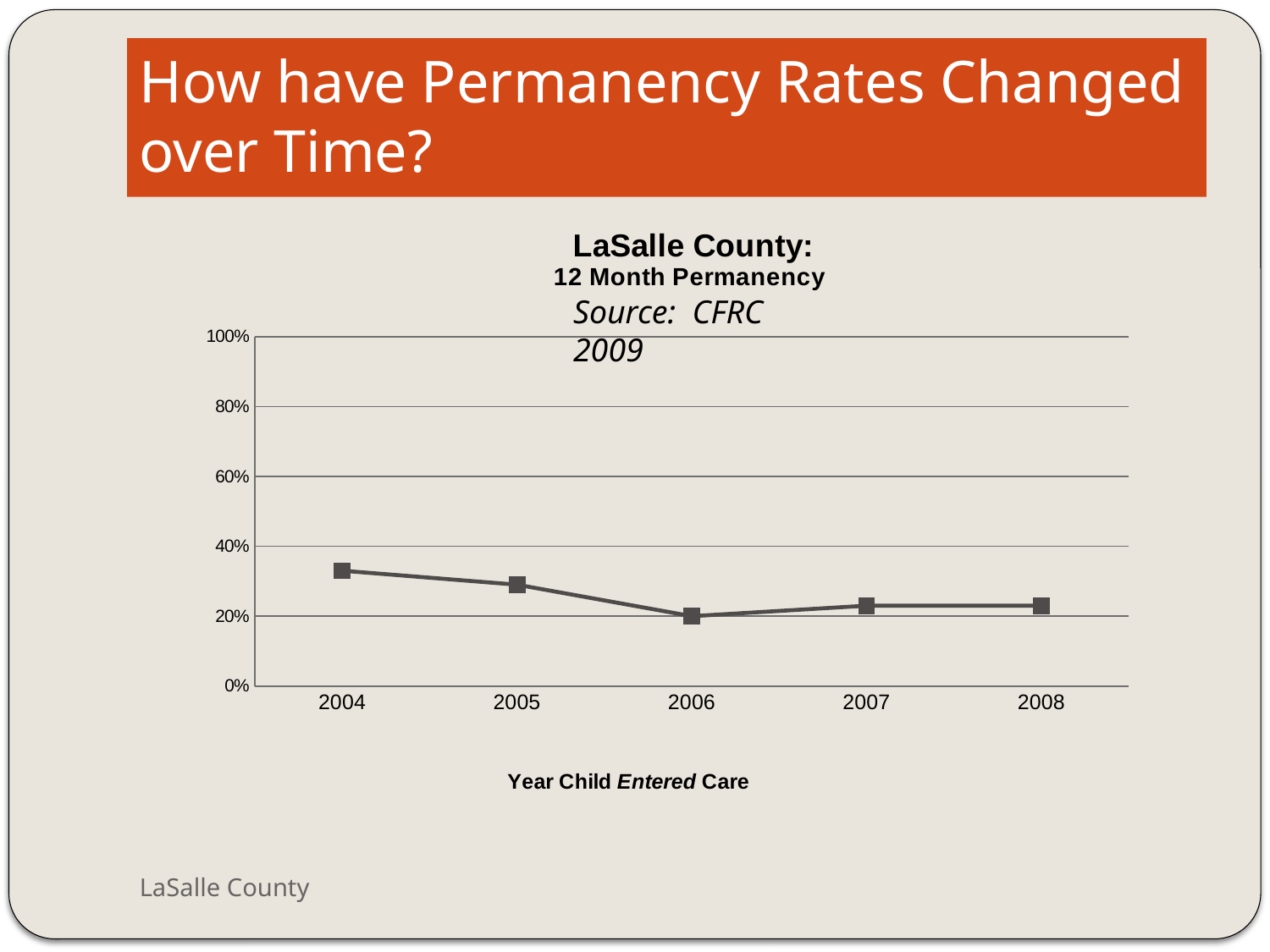
What kind of chart is shown on the slide? Line chart Is the value for 2004 greater or less than 20%? greater Which year has the higher permanency rate, 2004 or 2005? 2004 How many years are plotted on the x axis of the chart? 5 Is the value for 2008 greater or less than 40%? less Which year has the lowest 12 month permanency rate? 2006 Which year has the highest 12 month permanency rate? 2004 Is the value for 2004 greater or less than 40%? less What is the title of the x axis? Year Child Entered Care Does the permanency rate rise or fall from 2004 to 2006? Fall What source is cited for the chart data? CFRC 2009 Which year has the higher permanency rate, 2004 or 2008? 2004